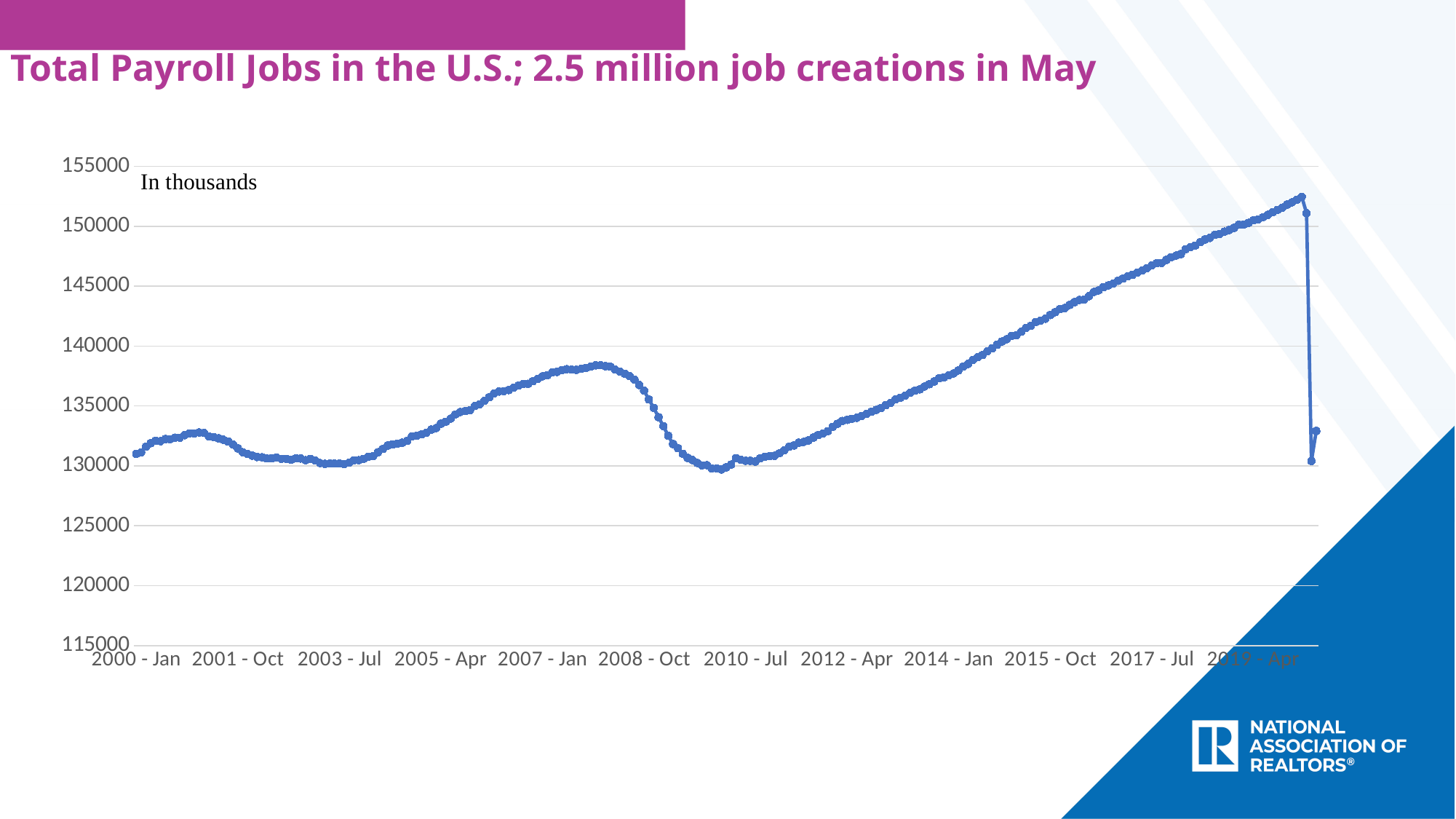
Which is larger, the value for 2001 - Oct or the value for 2014 - Jan? 2014 - Jan Is the value for 2010 - Jul greater or less than 135000? less Is the value for 2007 - Jan greater or less than 135000? greater Which of the labeled x-axis dates has the highest value: 2007 - Jan or 2019 - Apr? 2019 - Apr What unit note is printed inside the chart area? In thousands What is the title of the chart on the slide? Total Payroll Jobs in the U.S.; 2.5 million job creations in May What kind of chart is shown on the slide? Line chart Do the values rise or fall between 2010 - Jul and 2019 - Apr? rise Is the value for 2017 - Jul greater or less than 145000? greater Do the values rise or fall between 2008 - Oct and 2010 - Jul? fall